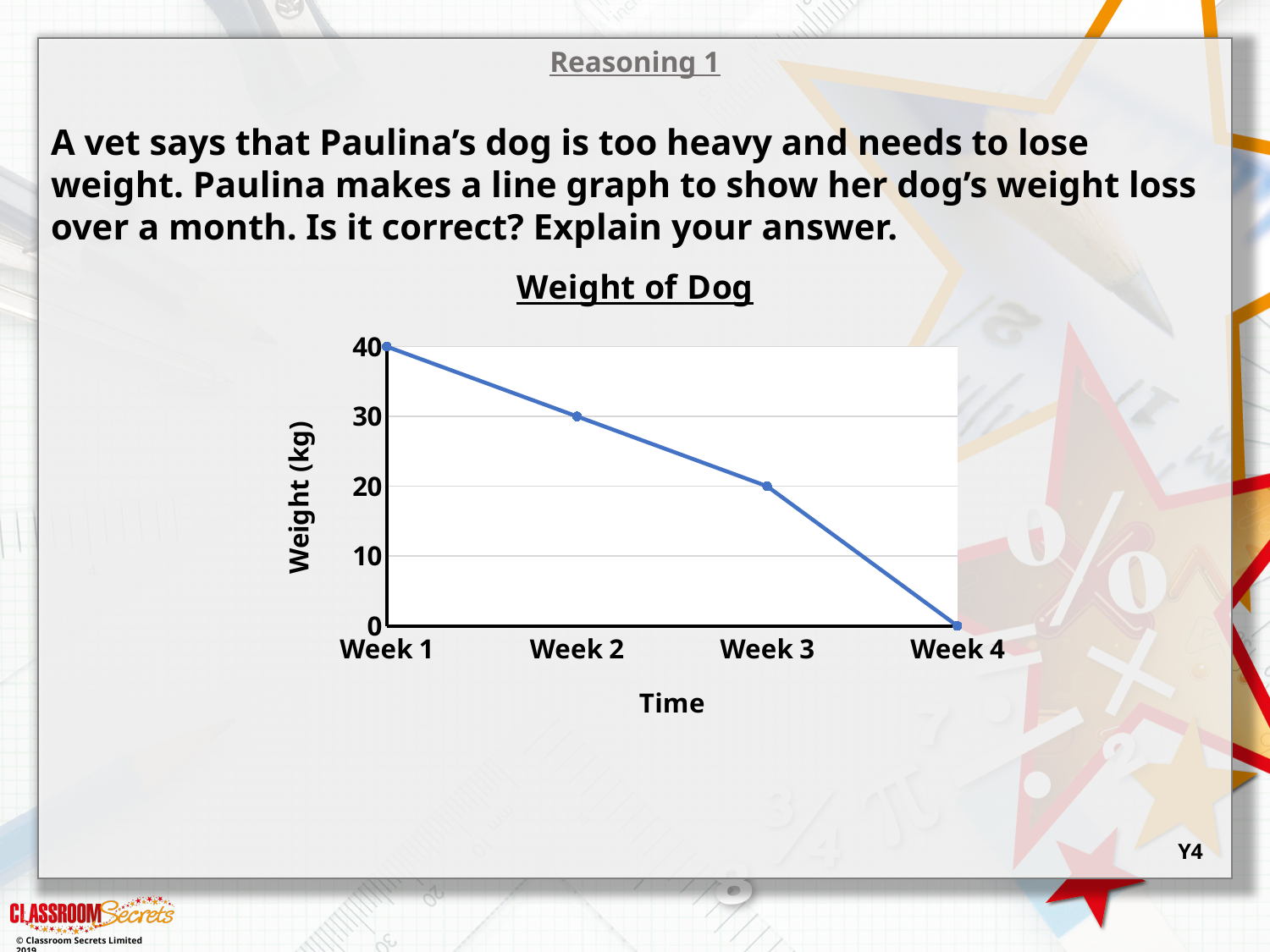
How many weeks are plotted on the chart? 4 What is the dog's weight in Week 1? 40 What is the title of the chart? Weight of Dog Does the dog's weight rise or fall from Week 1 to Week 4? fall What is the difference between the dog's weight in Week 1 and Week 3? 20 What is the dog's weight in Week 3? 20 What is the label on the vertical axis of the chart? Weight (kg) What is the dog's weight in Week 4? 0 What is the dog's weight in Week 2? 30 In which week is the dog's weight lowest? Week 4 What type of chart is shown on the slide? line chart In which week is the dog's weight highest? Week 1